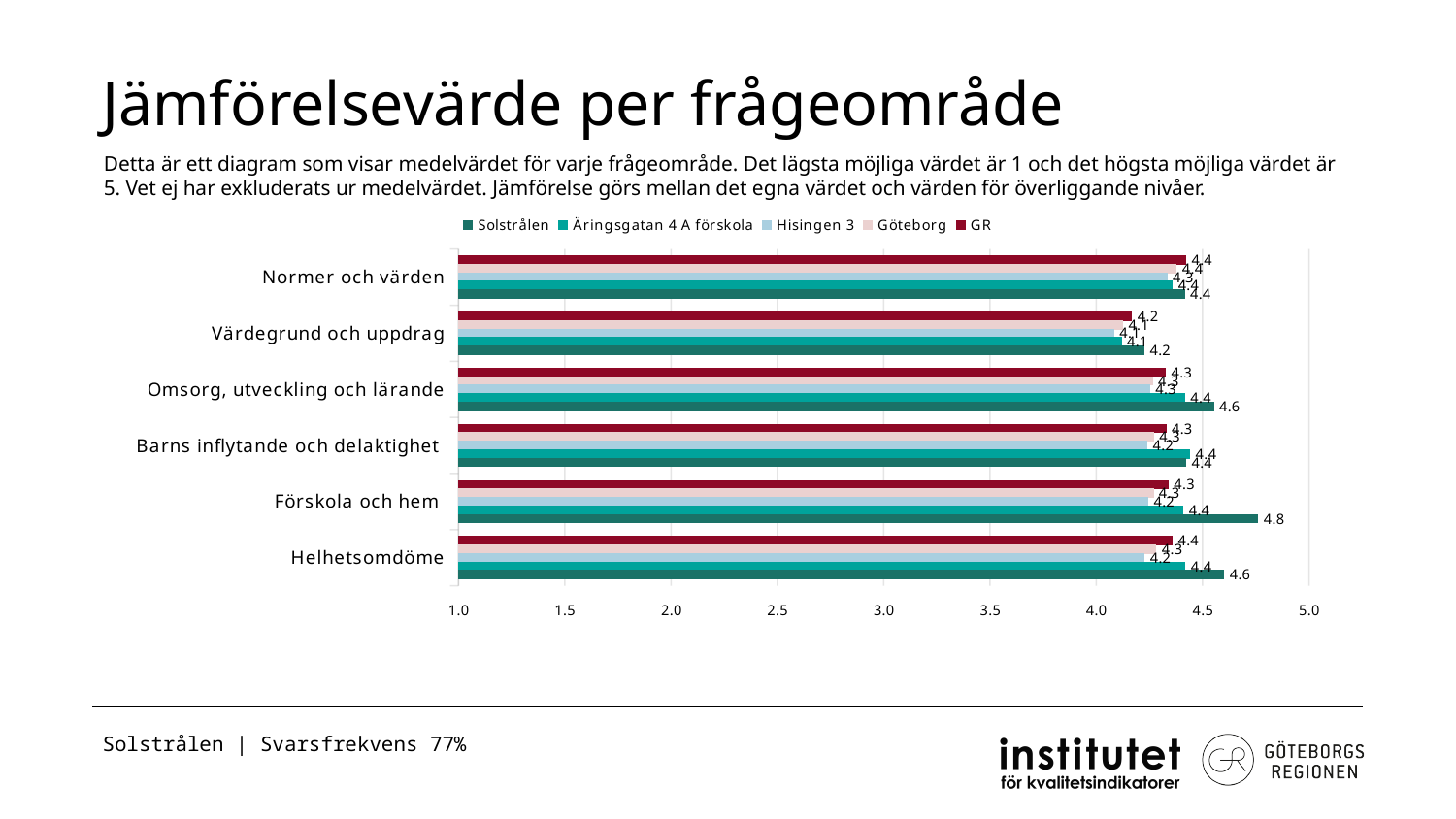
What is the value for Solstrålen in 'Förskola och hem'? 4.8 What is the value for Solstrålen in 'Värdegrund och uppdrag'? 4.2 In which category does Solstrålen have its highest value? Förskola och hem What kind of chart is shown on the slide? bar chart What is the difference between Solstrålen (4.8) and GR (4.3) in 'Förskola och hem'? 0.5 What is the value for GR in 'Normer och värden'? 4.4 In which category does Solstrålen have its lowest value? Värdegrund och uppdrag How many series does the legend list? 5 How many question areas (categories) are shown on the y axis? 6 What is the value for Solstrålen in 'Helhetsomdöme'? 4.6 Which is larger in 'Omsorg, utveckling och lärande': Solstrålen or GR? Solstrålen Which series is listed first in the legend? Solstrålen